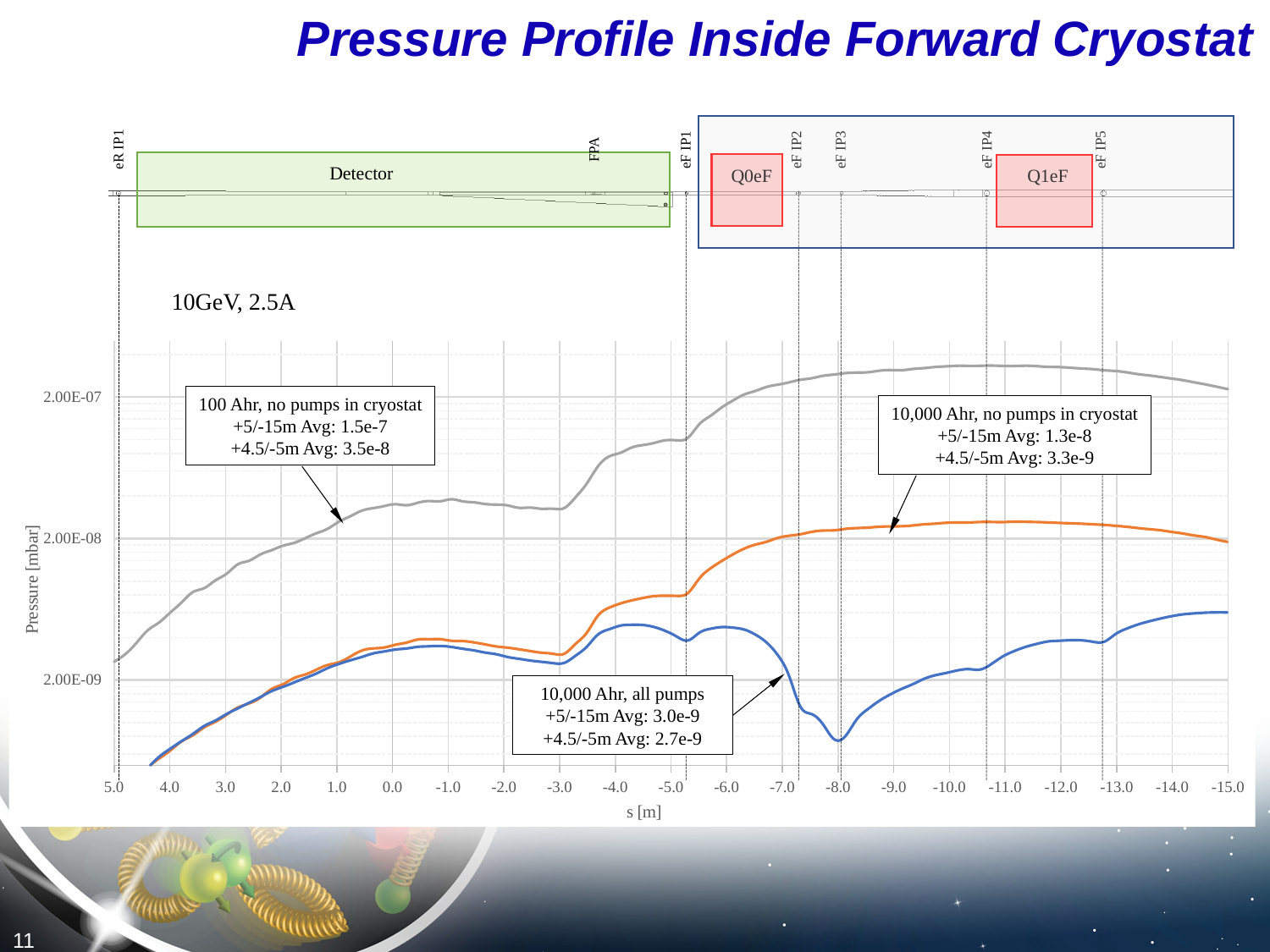
Is the pressure of the blue (10,000 Ahr, all pumps) curve at s = -8.0 m greater or less than 2.00E-09 mbar? less What kind of chart is shown on the slide? line chart Which of the three annotated cases has the lowest +4.5/-5m average pressure? 10,000 Ahr, all pumps How many pressure curves are plotted on the chart? 3 What is the label of the vertical axis of the chart? Pressure [mbar] Which of the three annotated cases has the highest +5/-15m average pressure? 100 Ahr, no pumps in cryostat Is the pressure of the gray (100 Ahr, no pumps) curve at s = -10.0 m greater or less than 2.00E-07 mbar? greater What is the +5/-15m average pressure for the 100 Ahr, no pumps in cryostat case? 1.5e-7 What is the +5/-15m average pressure for the 10,000 Ahr, no pumps in cryostat case? 1.3e-8 What is the +4.5/-5m average pressure for the 100 Ahr, no pumps in cryostat case? 3.5e-8 Which case has the higher +5/-15m average pressure: 10,000 Ahr with no pumps in cryostat, or 10,000 Ahr with all pumps? 10,000 Ahr, no pumps in cryostat What is the +4.5/-5m average pressure for the 10,000 Ahr, all pumps case? 2.7e-9